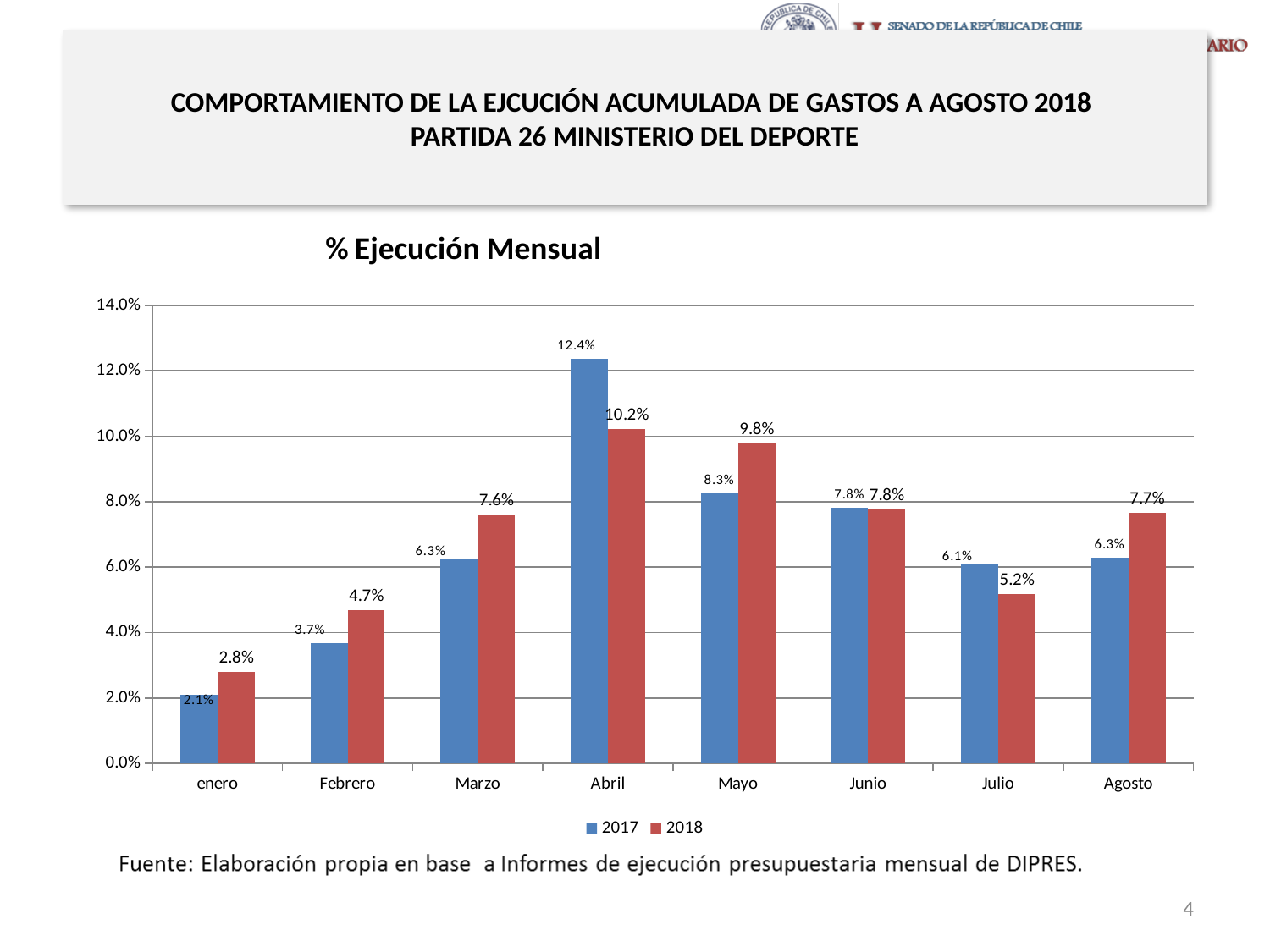
How many months are shown on the x axis? 8 What is the difference between the 2017 and 2018 values in Abril? 2.2% Which month has the lowest value for the 2017 series? enero Is the value for 2018 in Marzo greater or less than 6.0%? greater What kind of chart is shown? bar chart What is the value for 2018 in Mayo? 9.8% Which month has the highest value for the 2018 series? Abril What is the value for 2017 in Abril? 12.4% How many series does the legend list? 2 What is the title of the chart? % Ejecución Mensual Which is larger in Julio, the 2017 value or the 2018 value? 2017 What is the value for 2018 in enero? 2.8%